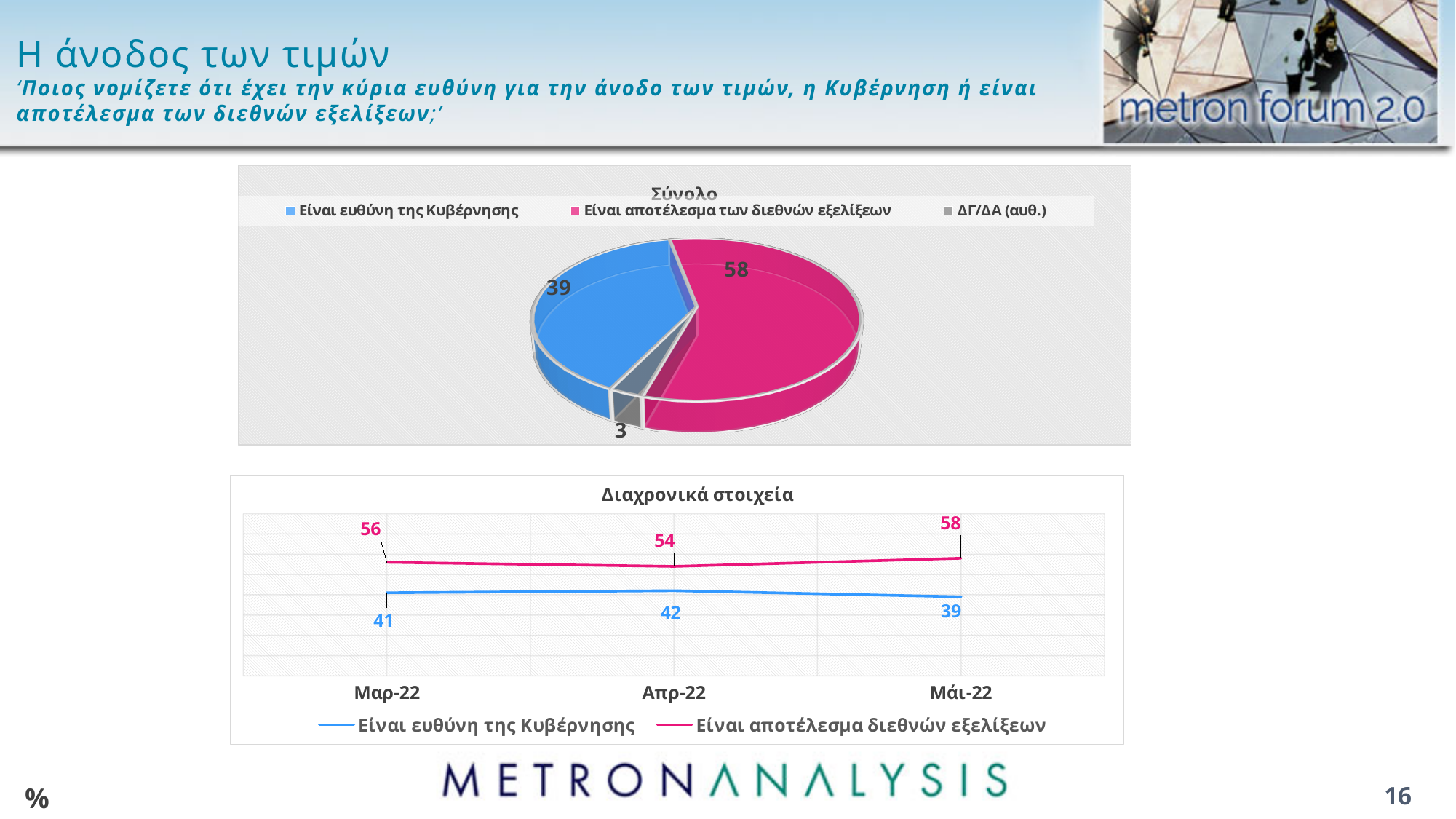
In the 'Διαχρονικά στοιχεία' chart, what is the value for 'Είναι ευθύνη της Κυβέρνησης' in Απρ-22? 42 In the 'Σύνολο' pie chart, what is the difference between 'Είναι αποτέλεσμα των διεθνών εξελίξεων' and 'Είναι ευθύνη της Κυβέρνησης'? 19 In the 'Διαχρονικά στοιχεία' chart, in which month is 'Είναι αποτέλεσμα διεθνών εξελίξεων' highest? Μάι-22 In the 'Διαχρονικά στοιχεία' chart, how many series does the legend list? 2 In the 'Σύνολο' pie chart, what is the value for 'Είναι αποτέλεσμα των διεθνών εξελίξεων'? 58 In the 'Σύνολο' pie chart, which category has the smallest slice? ΔΓ/ΔΑ (αυθ.) In the 'Σύνολο' pie chart, how many categories does the legend list? 3 In the 'Σύνολο' pie chart, what is the value for 'Είναι ευθύνη της Κυβέρνησης'? 39 In the 'Διαχρονικά στοιχεία' chart, what is the value for 'Είναι αποτέλεσμα διεθνών εξελίξεων' in Μαρ-22? 56 What kind of chart is the 'Σύνολο' chart? Pie chart What kind of chart is the 'Διαχρονικά στοιχεία' chart? Line chart In the 'Διαχρονικά στοιχεία' chart, what is the difference between the two series in Μάι-22? 19